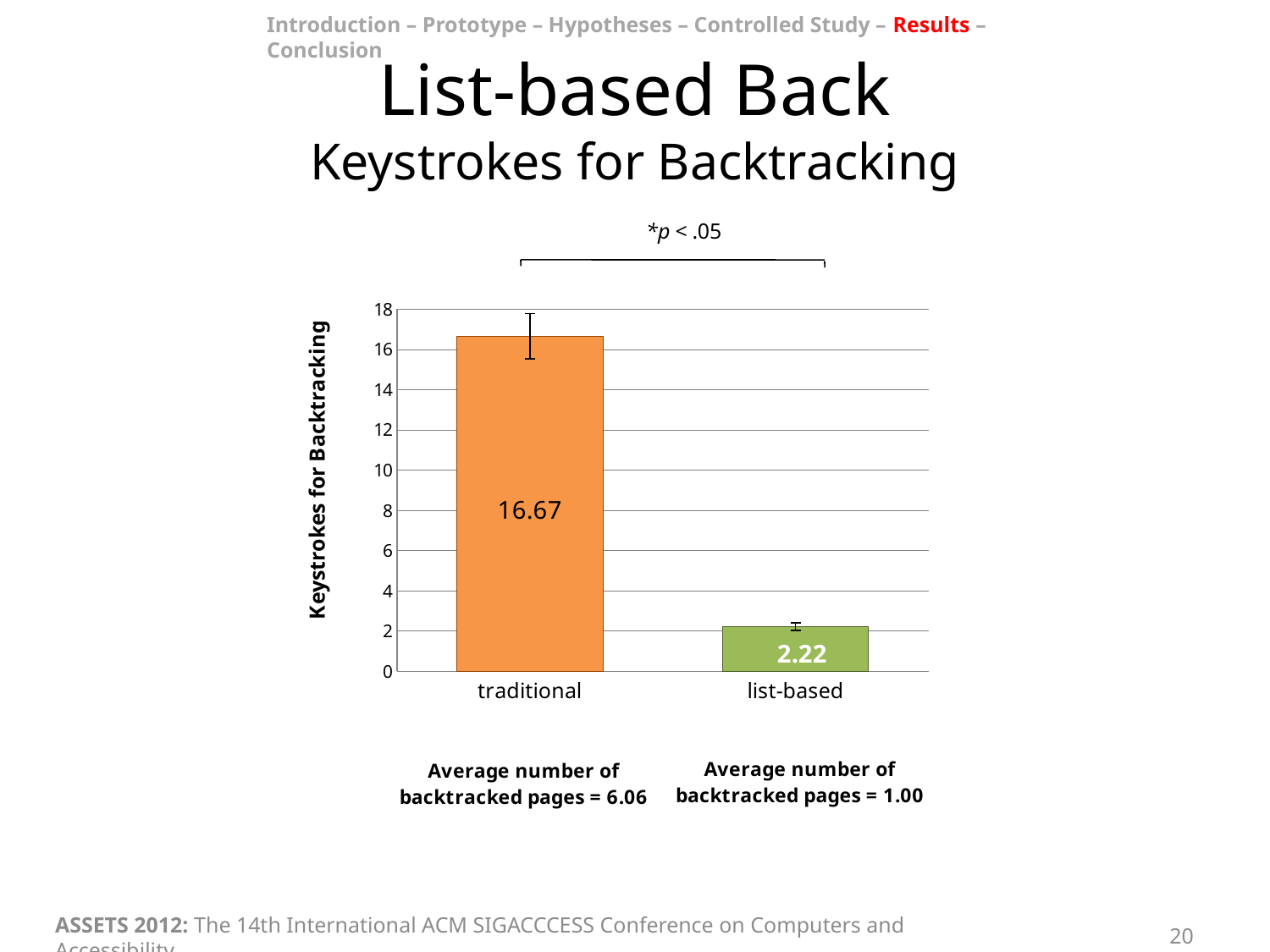
Which category has the highest keystrokes for backtracking? traditional Is the value for traditional greater or less than 14? greater Which is larger, the value for traditional or the value for list-based? traditional What kind of chart is shown on the slide? bar chart How many categories are shown on the x axis of the chart? 2 What is the difference between the traditional and list-based values? 14.45 What is the maximum value shown on the vertical axis of the chart? 18 What is the label of the vertical axis of the chart? Keystrokes for Backtracking What is the value for traditional in the Keystrokes for Backtracking chart? 16.67 What is the value for list-based in the Keystrokes for Backtracking chart? 2.22 Is the value for list-based greater or less than 4? less Which category has the lowest keystrokes for backtracking? list-based